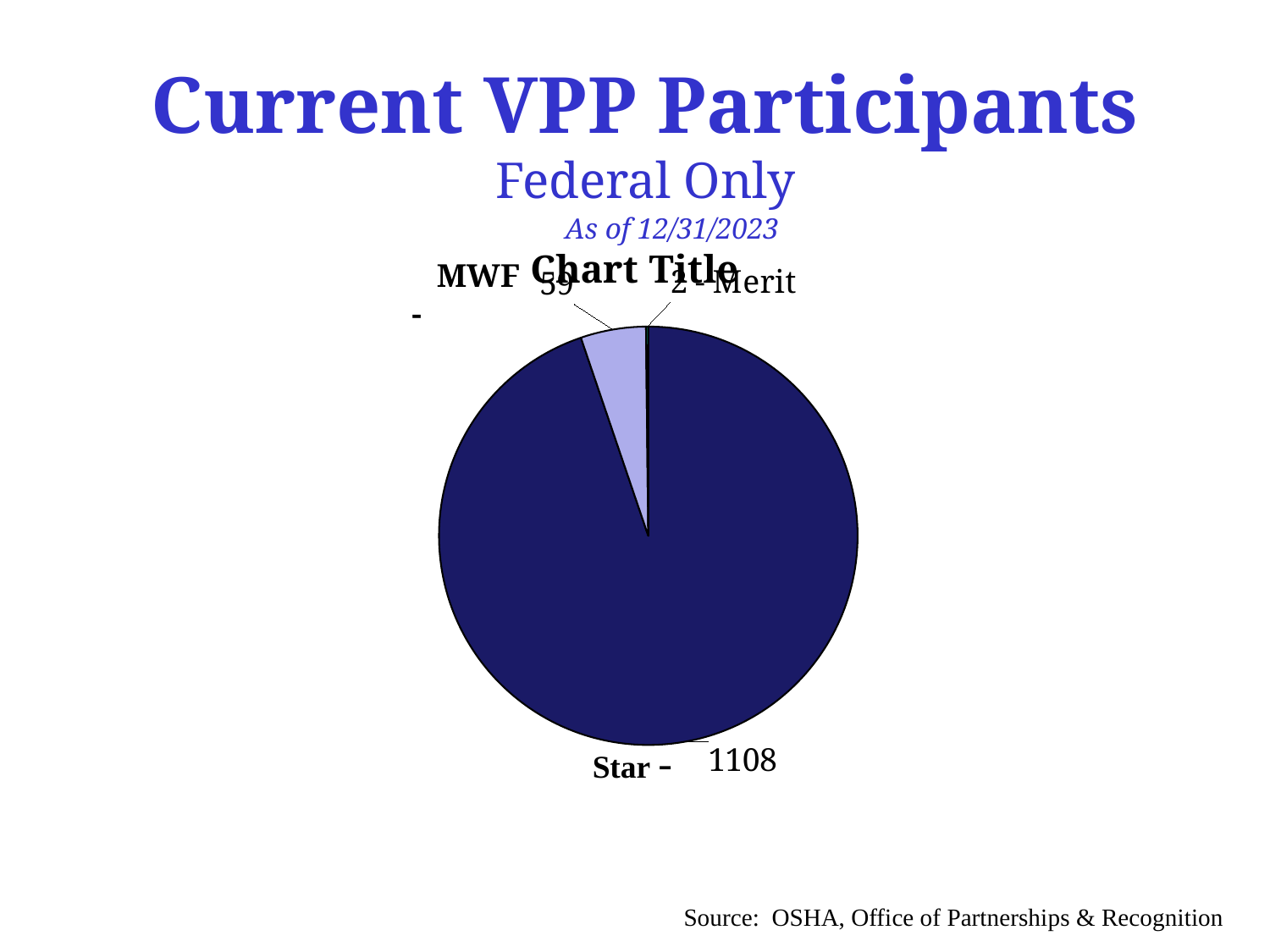
Which category has the smallest slice of the pie chart? Merit Which is larger, the value for Star or the value for MWF? Star What is the value for Star in the pie chart? 1108 What is the difference between the value for Star and the value for MWF? 1049 How many slices does the pie chart have? 3 What source is cited for the chart data? OSHA, Office of Partnerships & Recognition What date is the chart data current as of, according to the slide? 12/31/2023 What kind of chart is shown on the slide? pie chart What is the value for Merit in the pie chart? 2 What is the value for MWF in the pie chart? 59 Which category has the largest slice of the pie chart? Star What is the total of all slices in the pie chart? 1169